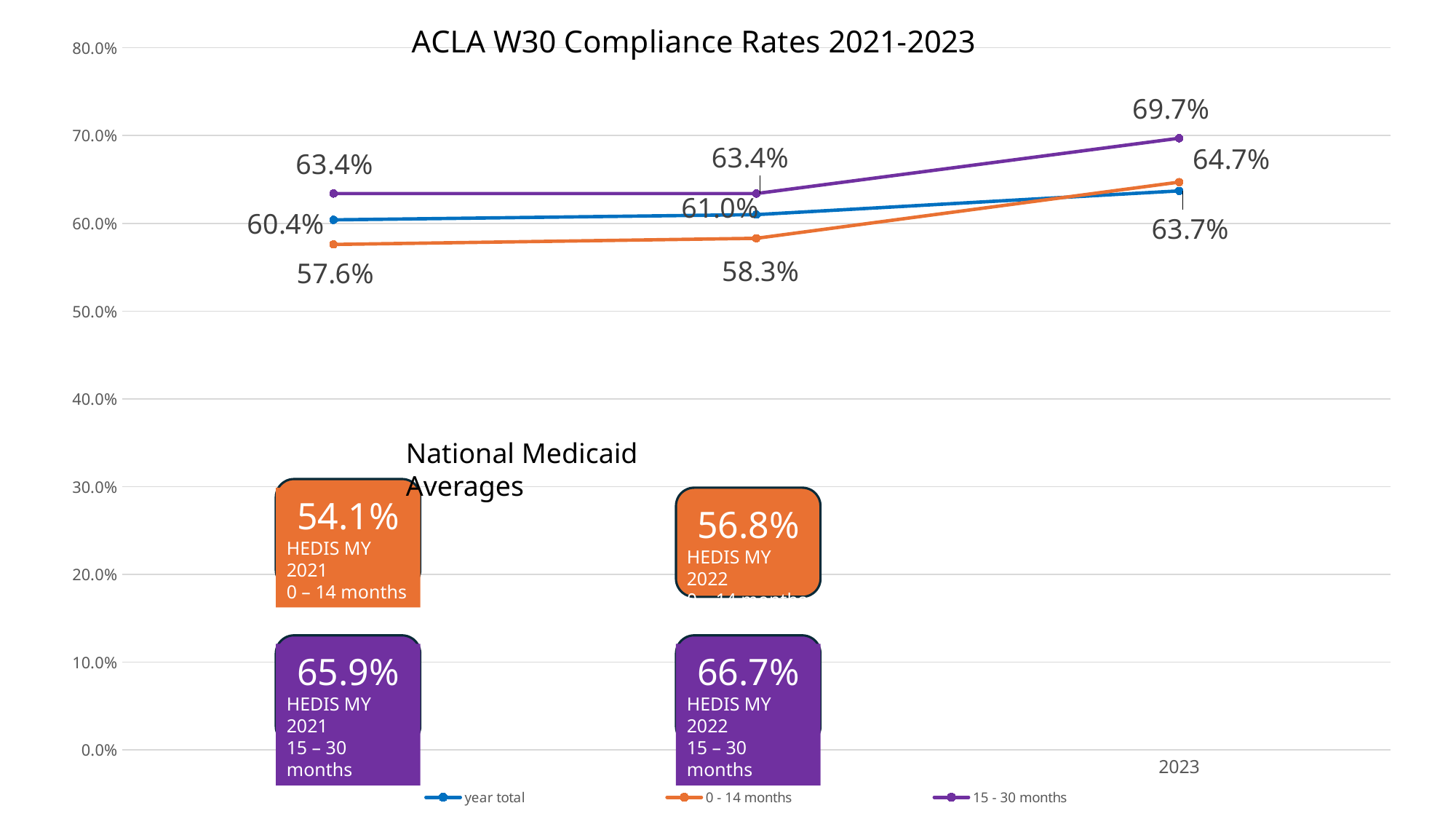
Does the 0 - 14 months rate rise or fall from 2021 to 2023? rise In 2023, which is larger: the 0 - 14 months rate or the year total rate? 0 - 14 months In which year is the 0 - 14 months rate lowest? 2021 What is the 0 - 14 months compliance rate in 2021? 57.6% How many data points does each series have? 3 How many series does the legend list? 3 What is the 15 - 30 months compliance rate in 2023? 69.7% What is the year total compliance rate in 2022? 61.0% By how many percentage points did the 15 - 30 months rate increase from 2021 to 2023? 6.3 percentage points Which series has the highest value in 2023? 15 - 30 months What kind of chart is shown on the slide? line chart What is the title of the chart? ACLA W30 Compliance Rates 2021-2023